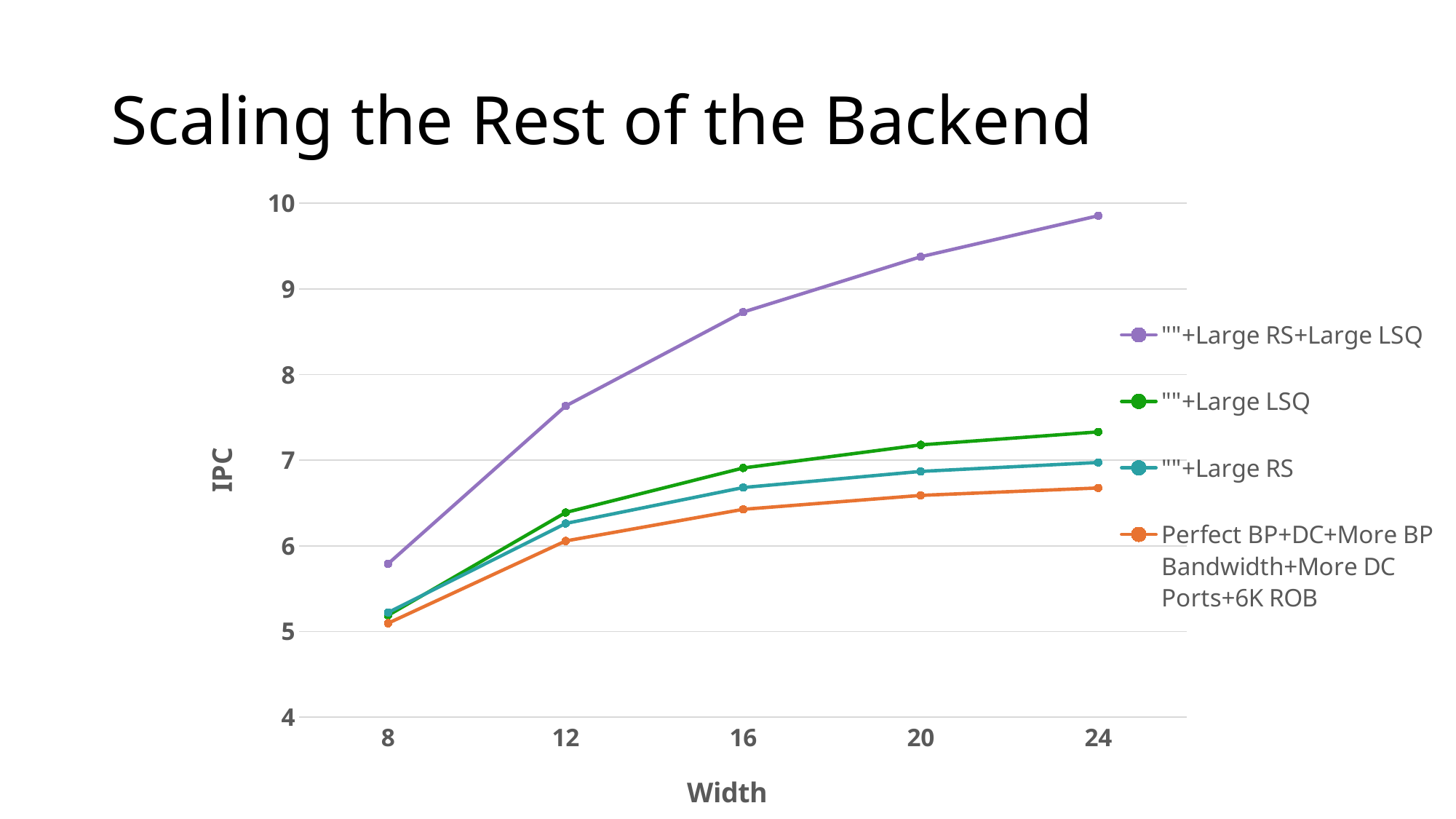
How many series does the legend list? 4 Is the IPC for ""+Large RS+Large LSQ at width 8 greater or less than 6? less Is the IPC for ""+Large RS+Large LSQ at width 16 greater or less than 8? greater Which series has the lowest IPC at width 24? Perfect BP+DC+More BP Bandwidth+More DC Ports+6K ROB At width 20, which series has the higher IPC: ""+Large LSQ or Perfect BP+DC+More BP Bandwidth+More DC Ports+6K ROB? ""+Large LSQ Is the IPC for ""+Large RS+Large LSQ at width 24 greater or less than 9? greater How many width values are plotted along the x axis? 5 Which series has the highest IPC at width 24? ""+Large RS+Large LSQ What is the label of the y axis? IPC What kind of chart is shown on the slide? line chart Does IPC rise or fall as Width increases for the ""+Large RS+Large LSQ series? rise